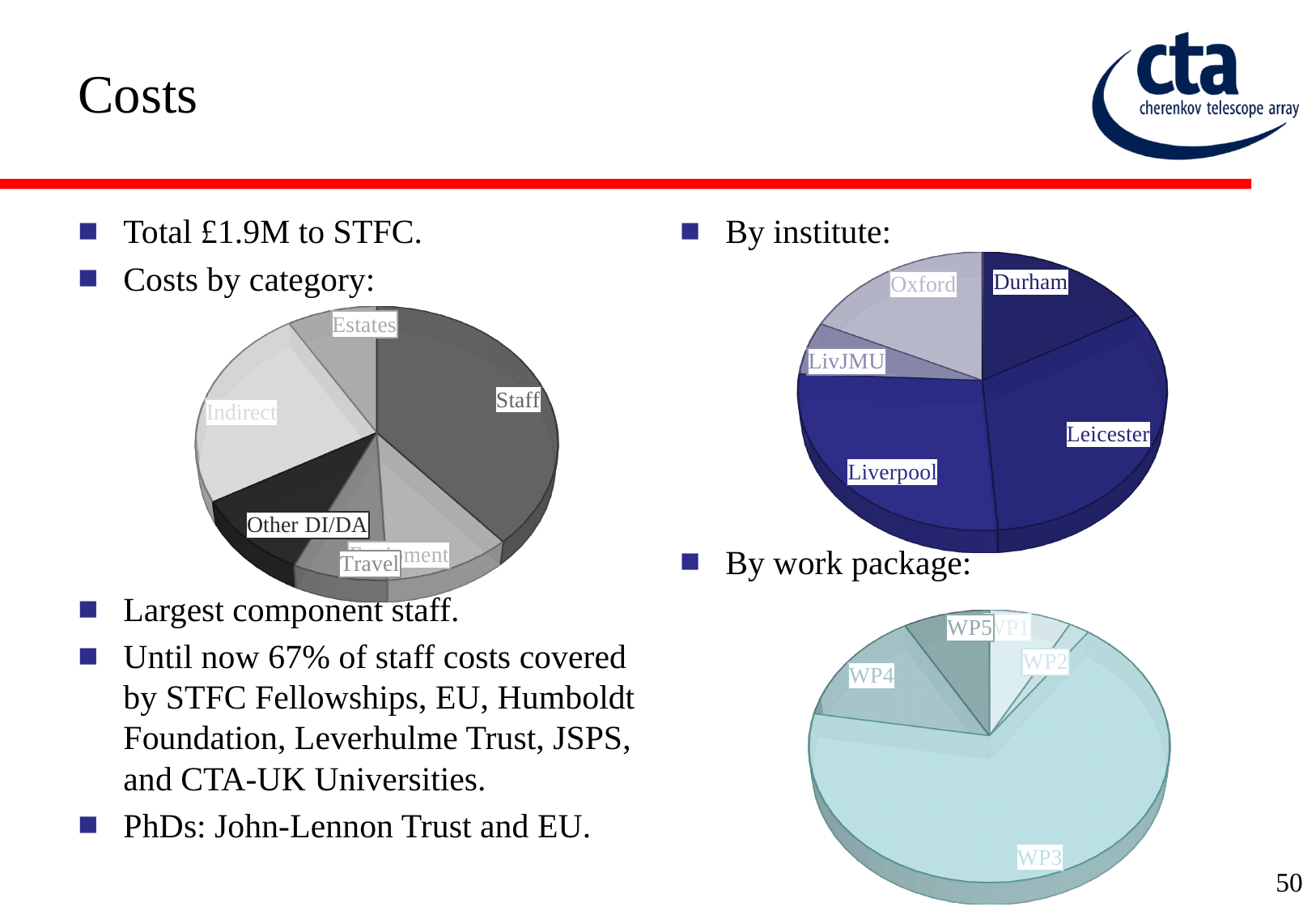
How many work packages are shown in the 'By work package' pie chart? 5 What kind of chart is the 'By institute' chart? pie chart What kind of chart is the 'By work package' chart? pie chart How many institutes are shown in the 'By institute' pie chart? 5 In the 'By work package' chart, which slice is larger, WP3 or WP4? WP3 How many slices does the 'Costs by category' pie chart have? 6 In the 'By institute' chart, which slice is larger, Durham or LivJMU? Durham In the 'By institute' chart, which institute has the smallest slice? LivJMU What kind of chart is the 'Costs by category' chart? pie chart In the 'Costs by category' chart, which category has the largest slice? Staff In the 'By work package' chart, which work package has the largest slice? WP3 How many pie charts are shown on the slide? 3